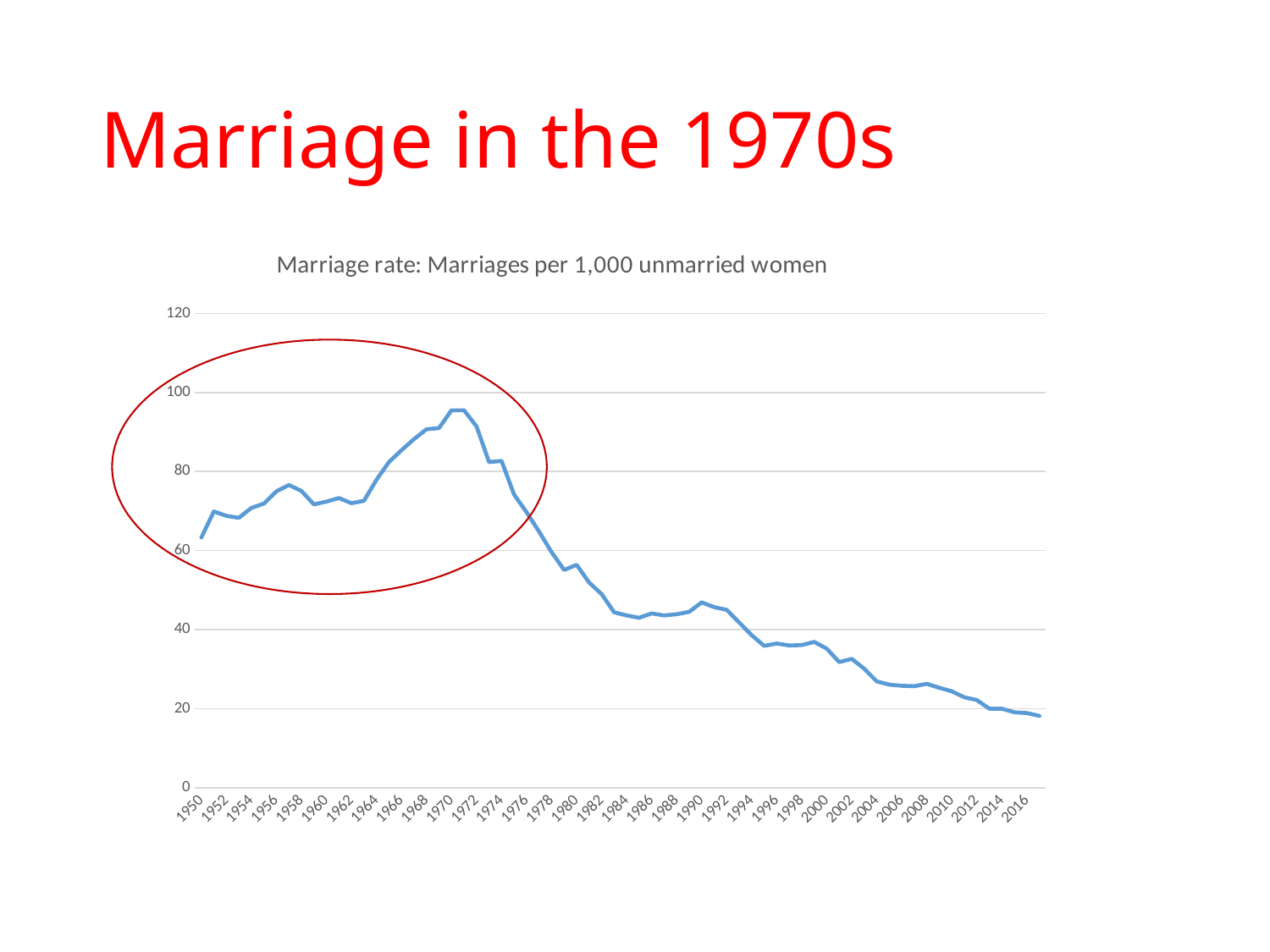
What kind of chart is shown on the slide? line chart Which year has the lowest marriage rate on the chart? 2017 What is the title of the chart? Marriage rate: Marriages per 1,000 unmarried women Is the value for 1950 greater or less than 80? less Does the marriage rate rise or fall between 1972 and 2016? fall Which is larger, the marriage rate in 1960 or in 1990? 1960 What is the highest value shown on the vertical axis? 120 Is the value for 1990 greater or less than 60? less Is the value for 2016 greater or less than 40? less Does the marriage rate rise or fall between 1962 and 1970? rise